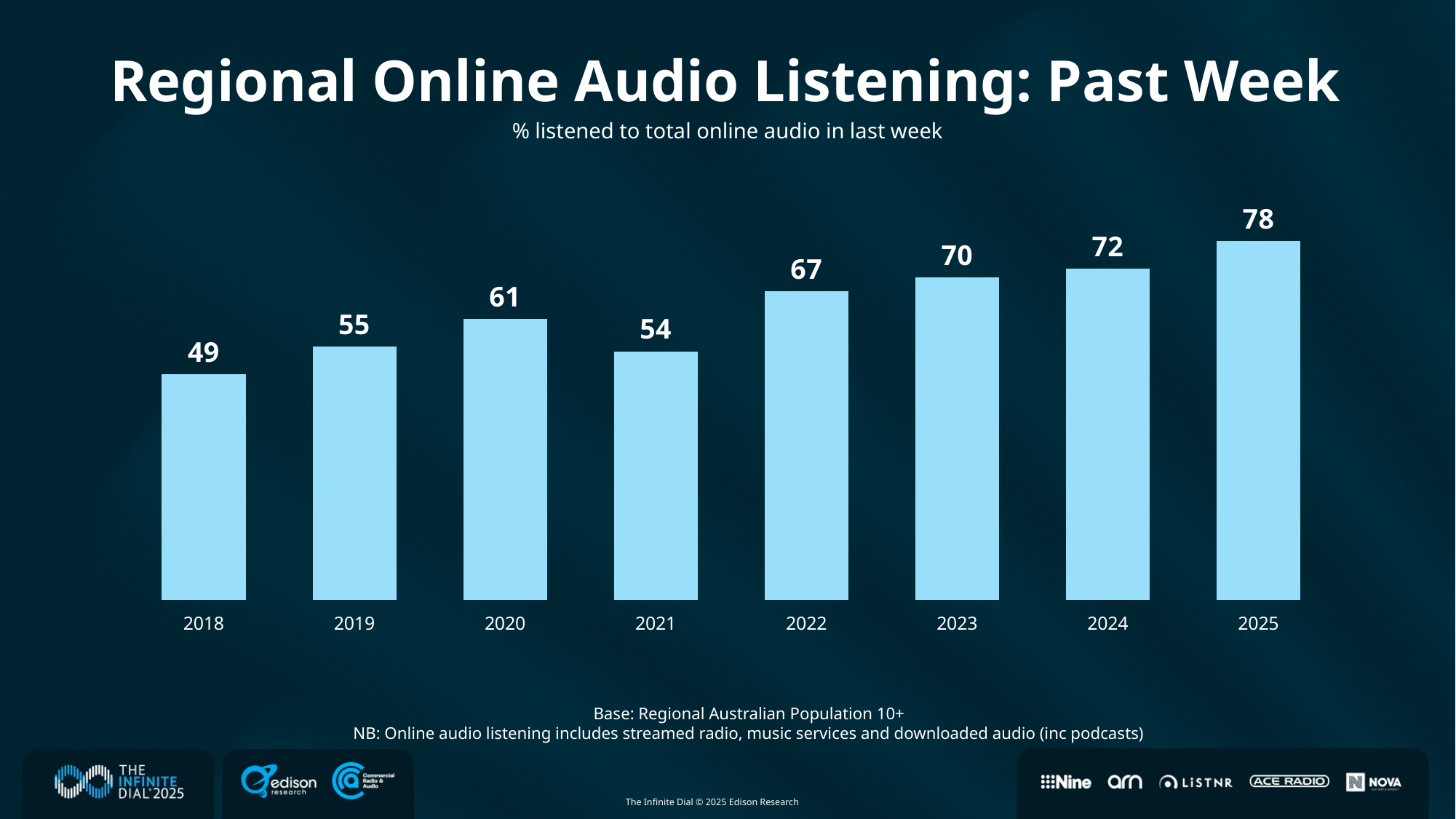
What is the difference between the values for 2025 and 2018? 29 What is the value for 2018? 49 What kind of chart is shown on the slide? bar chart Which year has the highest value? 2025 How many years are shown on the chart? 8 What is the title of the chart? Regional Online Audio Listening: Past Week What is the value for 2025? 78 Which year has the lowest value? 2018 Do the values generally rise or fall from 2021 to 2025? rise What is the difference between the values for 2020 and 2021? 7 Which is larger, the value for 2020 or the value for 2021? 2020 What is the value for 2021? 54